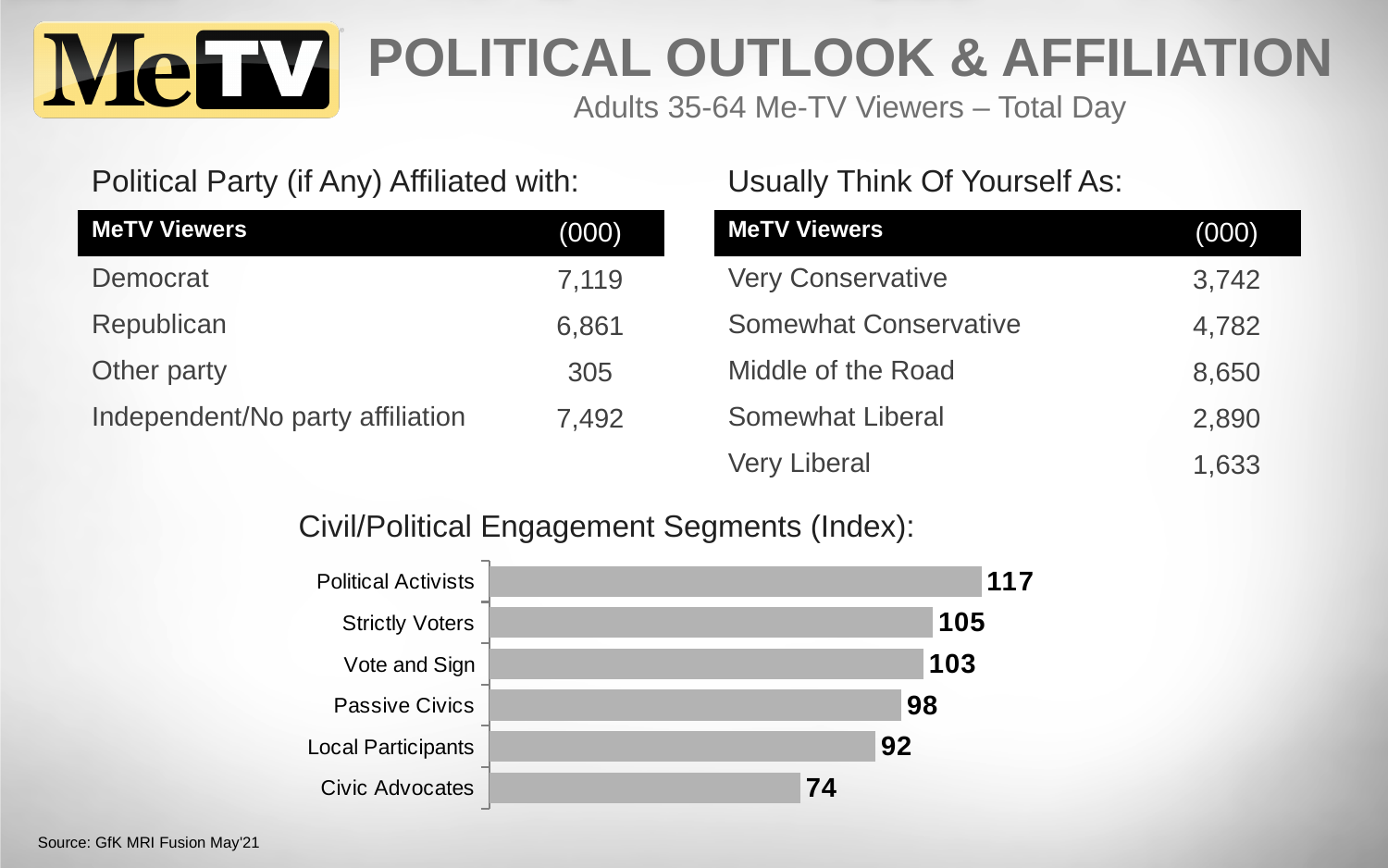
What is the title of the bar chart on the slide? Civil/Political Engagement Segments (Index): What type of chart is the Civil/Political Engagement Segments chart? Bar chart What is the index value for Passive Civics in the Civil/Political Engagement Segments chart? 98 What is the difference between the index values for Strictly Voters and Vote and Sign in the Civil/Political Engagement Segments chart? 2 In the Civil/Political Engagement Segments chart, which has a higher index: Passive Civics or Local Participants? Passive Civics What is the difference between the index values for Political Activists and Civic Advocates in the Civil/Political Engagement Segments chart? 43 How many segments are shown in the Civil/Political Engagement Segments chart? 6 What is the index value for Political Activists in the Civil/Political Engagement Segments chart? 117 Which segment has the highest index in the Civil/Political Engagement Segments chart? Political Activists What is the index value for Local Participants in the Civil/Political Engagement Segments chart? 92 What is the index value for Civic Advocates in the Civil/Political Engagement Segments chart? 74 Which segment has the lowest index in the Civil/Political Engagement Segments chart? Civic Advocates